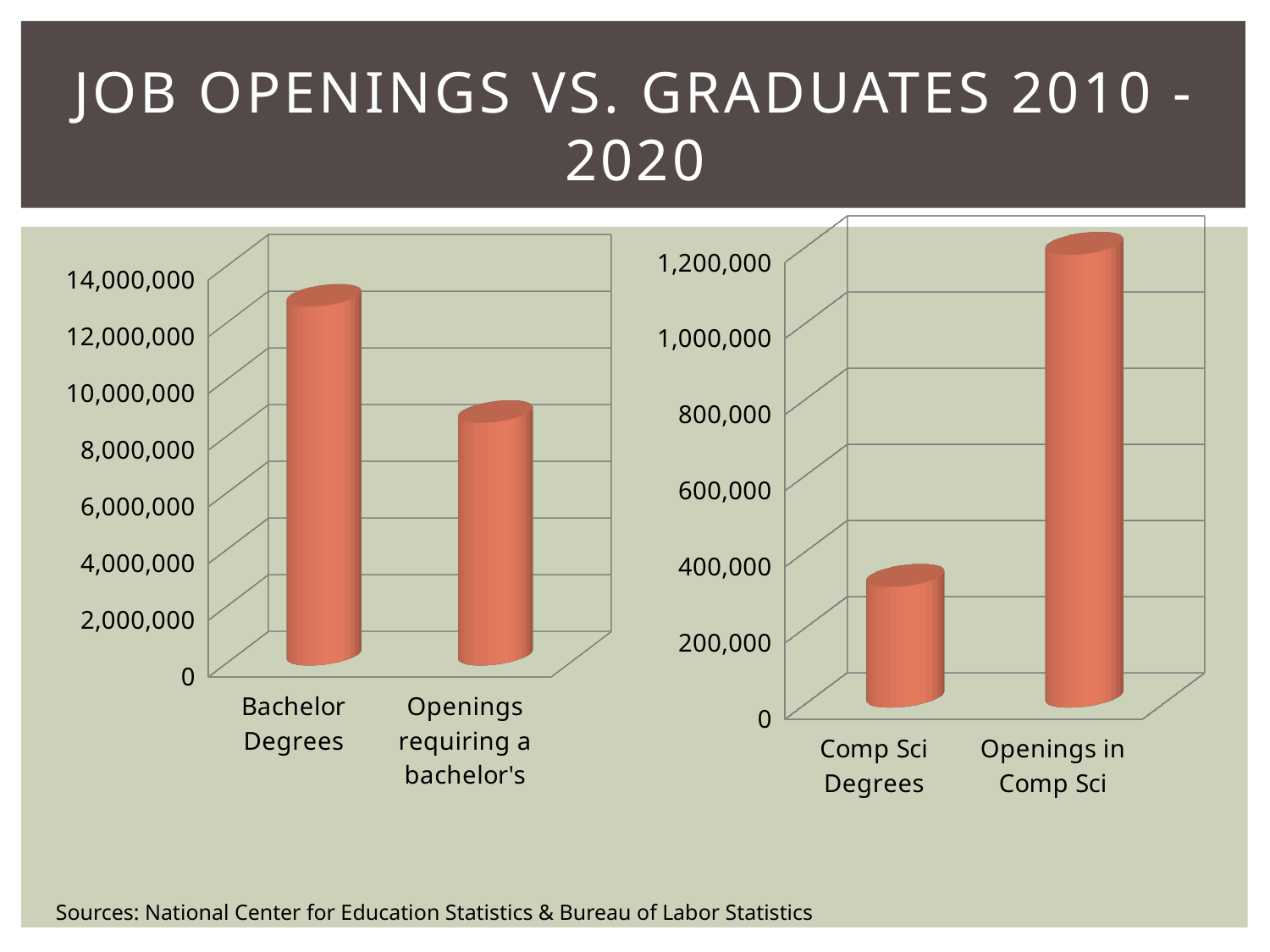
On the left chart, is the value for Openings requiring a bachelor's greater or less than 10,000,000? less On the left chart, is the value for Bachelor Degrees greater or less than 12,000,000? greater On the left chart, which category has the lowest value? Openings requiring a bachelor's What is the highest value shown on the y axis of the left chart? 14,000,000 On the right chart, which category has the highest value? Openings in Comp Sci On the right chart, is the value for Openings in Comp Sci greater or less than 1,000,000? greater On the left chart, which category has the higher value, Bachelor Degrees or Openings requiring a bachelor's? Bachelor Degrees How many categories are shown on the right chart? 2 What kind of chart is the right chart? Bar chart How many categories are shown on the left chart? 2 On the right chart, which category has the higher value, Comp Sci Degrees or Openings in Comp Sci? Openings in Comp Sci